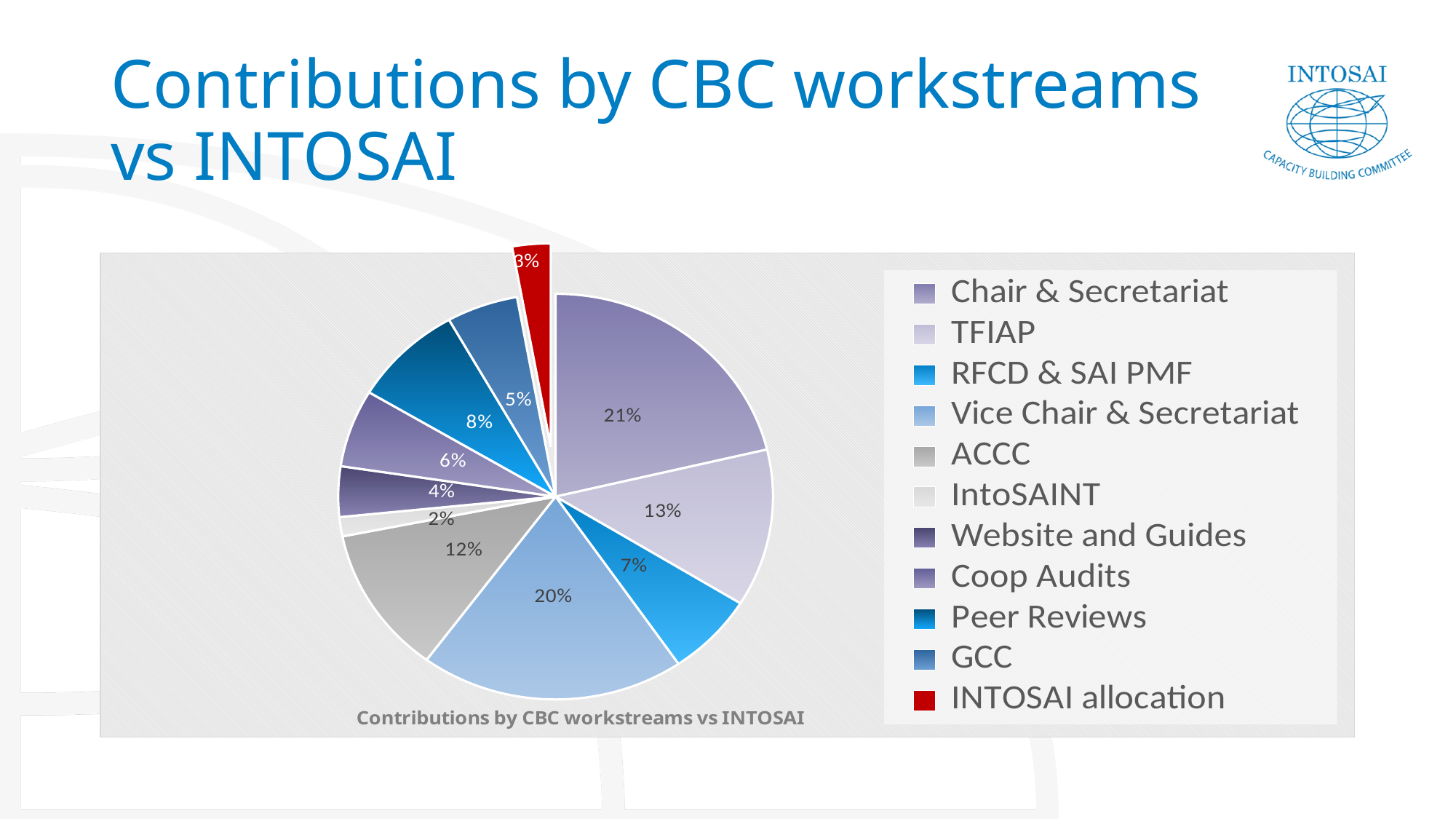
What is the title printed beneath the chart? Contributions by CBC workstreams vs INTOSAI What share of the pie does Chair & Secretariat hold? 21% What type of chart is shown on the slide? Pie chart Which is larger, the share for Peer Reviews or the share for GCC? Peer Reviews What is the difference in percentage points between TFIAP and RFCD & SAI PMF? 6 What is the value for the INTOSAI allocation slice? 3% Which category has the largest share of the pie? Chair & Secretariat What percentage is shown for Vice Chair & Secretariat? 20% What percentage is shown for ACCC? 12% How many categories does the legend list? 11 Which legend entry is shown in red? INTOSAI allocation Which category has the smallest share of the pie? IntoSAINT